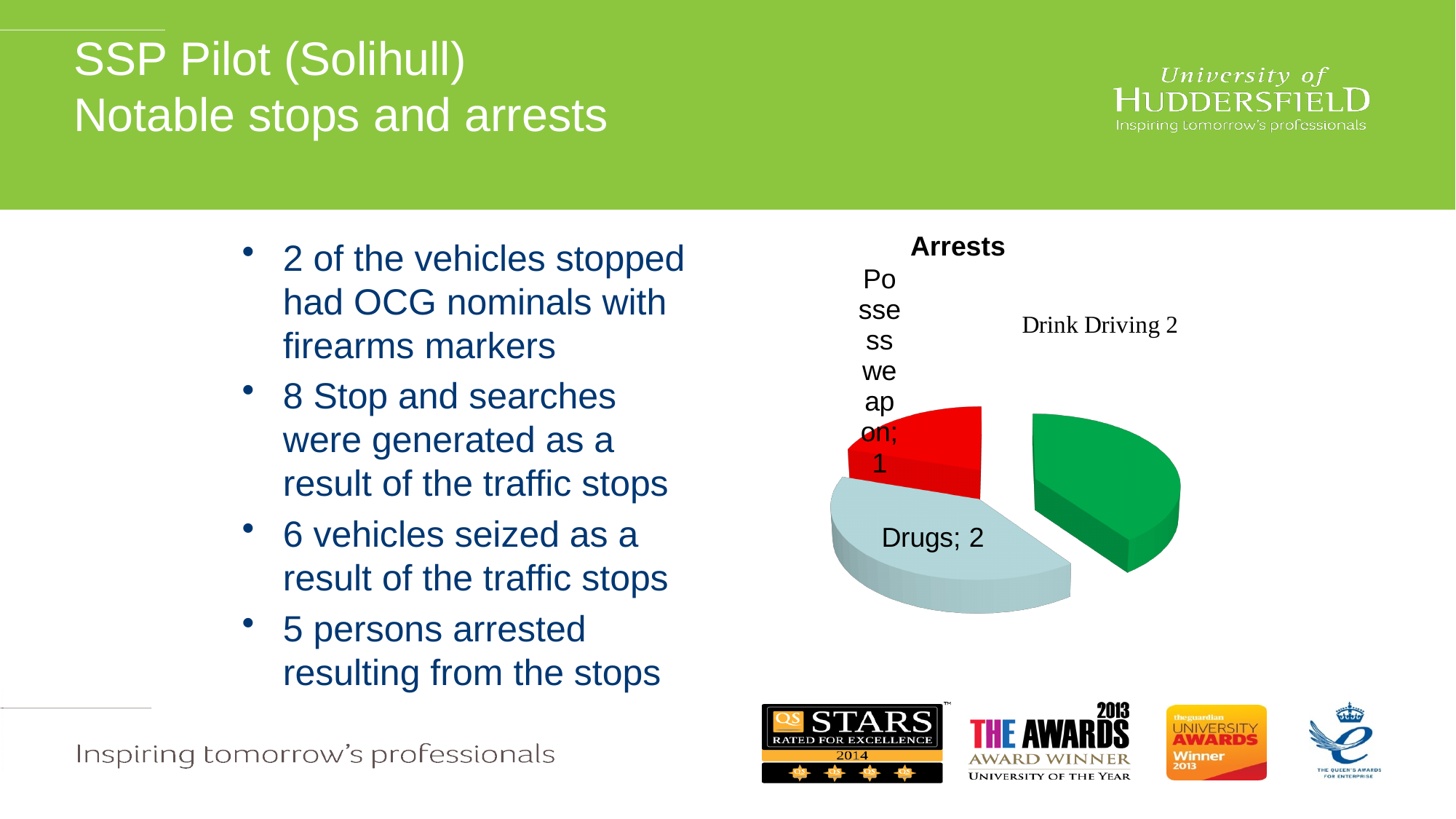
What is the value for Possess weapon in the Arrests pie chart? 1 What is the difference between the Drugs value and the Possess weapon value in the Arrests pie chart? 1 What is the value for Drink Driving in the Arrests pie chart? 2 What is the value for Drugs in the Arrests pie chart? 2 What is the title of the chart on the slide? Arrests What colour is the Drink Driving slice in the Arrests pie chart? green What kind of chart is shown under the title "Arrests"? pie chart How many slices does the Arrests pie chart have? 3 What share of the Arrests pie chart does the Drugs slice represent? 40% Which category has the lowest value in the Arrests pie chart? Possess weapon What is the total of all slices in the Arrests pie chart? 5 Which is larger in the Arrests pie chart, Drugs or Possess weapon? Drugs